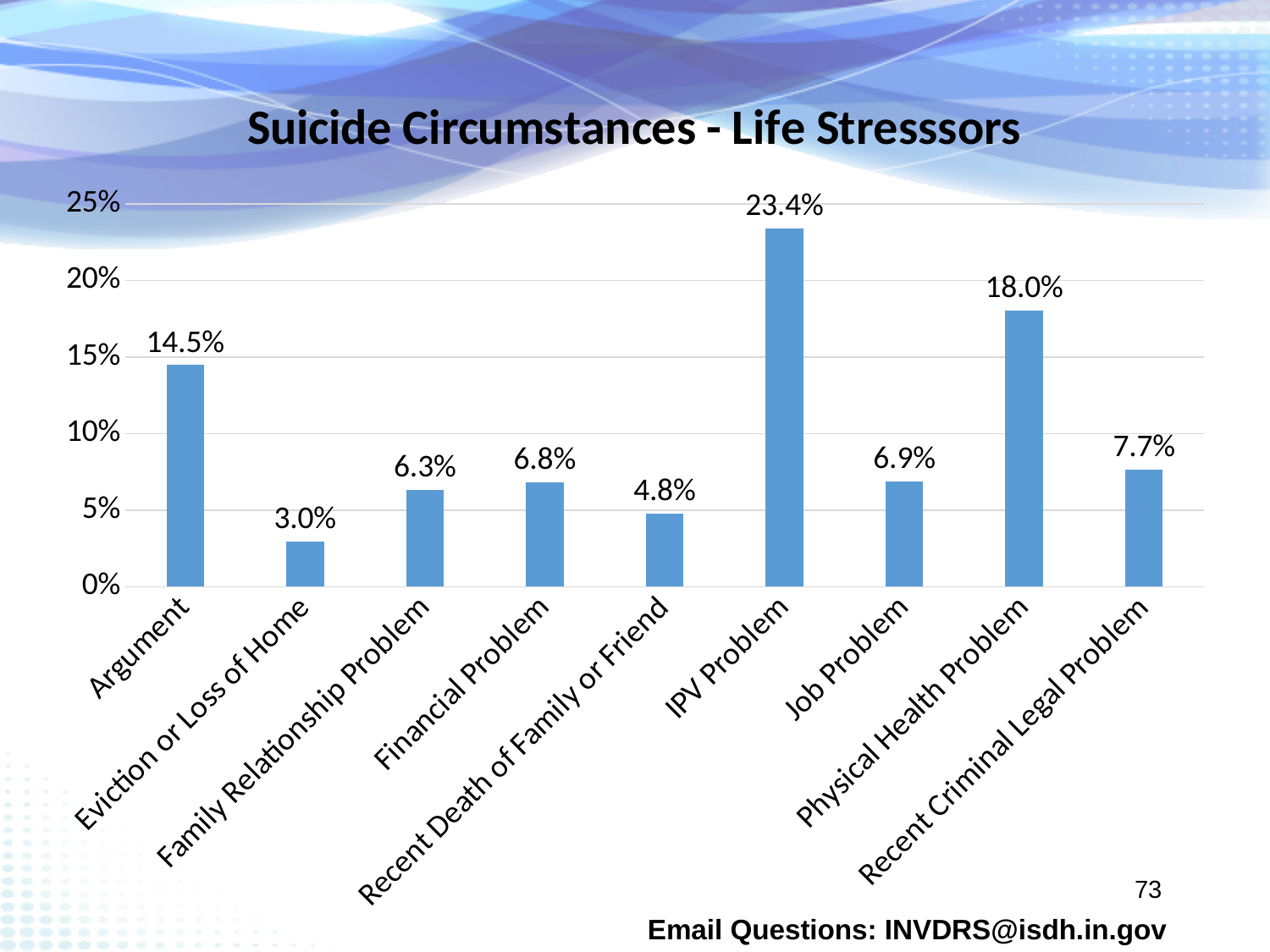
How many categories are shown on the x axis? 9 What kind of chart is shown on the slide? bar chart Which category has the lowest value? Eviction or Loss of Home Which is larger, the value for Argument or the value for Job Problem? Argument What is the title of the chart? Suicide Circumstances - Life Stresssors Which category has the highest value? IPV Problem What is the value for Eviction or Loss of Home? 3.0% What is the value for IPV Problem? 23.4% What is the difference between the values for Argument and Recent Criminal Legal Problem? 6.8% What is the value for Physical Health Problem? 18.0% What is the difference between the values for IPV Problem and Physical Health Problem? 5.4% Is the value for Recent Death of Family or Friend greater or less than 5%? less